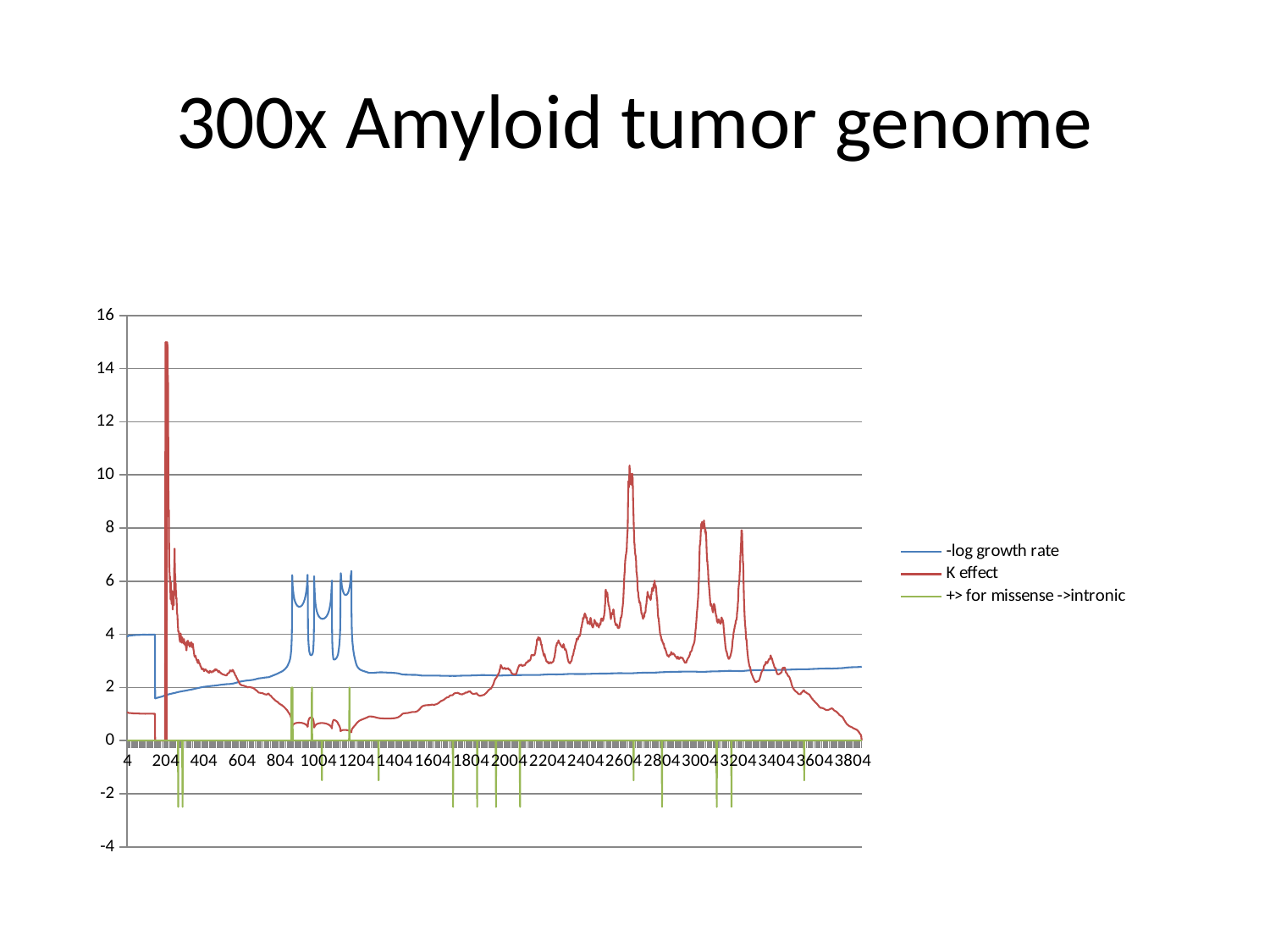
Near x = 1004, which series is higher: -log growth rate or K effect? -log growth rate Near x = 2604, which series is higher: K effect or -log growth rate? K effect Which series is drawn in red? K effect What kind of chart is shown on the slide? line chart Is the K effect peak near x = 2604 greater or less than 8? greater What is the highest value shown on the y axis? 16 Is the value of -log growth rate at x = 2004 greater or less than 4? less What is the title of the slide? 300x Amyloid tumor genome How many series does the legend list? 3 Which series reaches the highest value on the chart? K effect Is the highest peak of the K effect series (near x = 204) greater or less than 14? greater